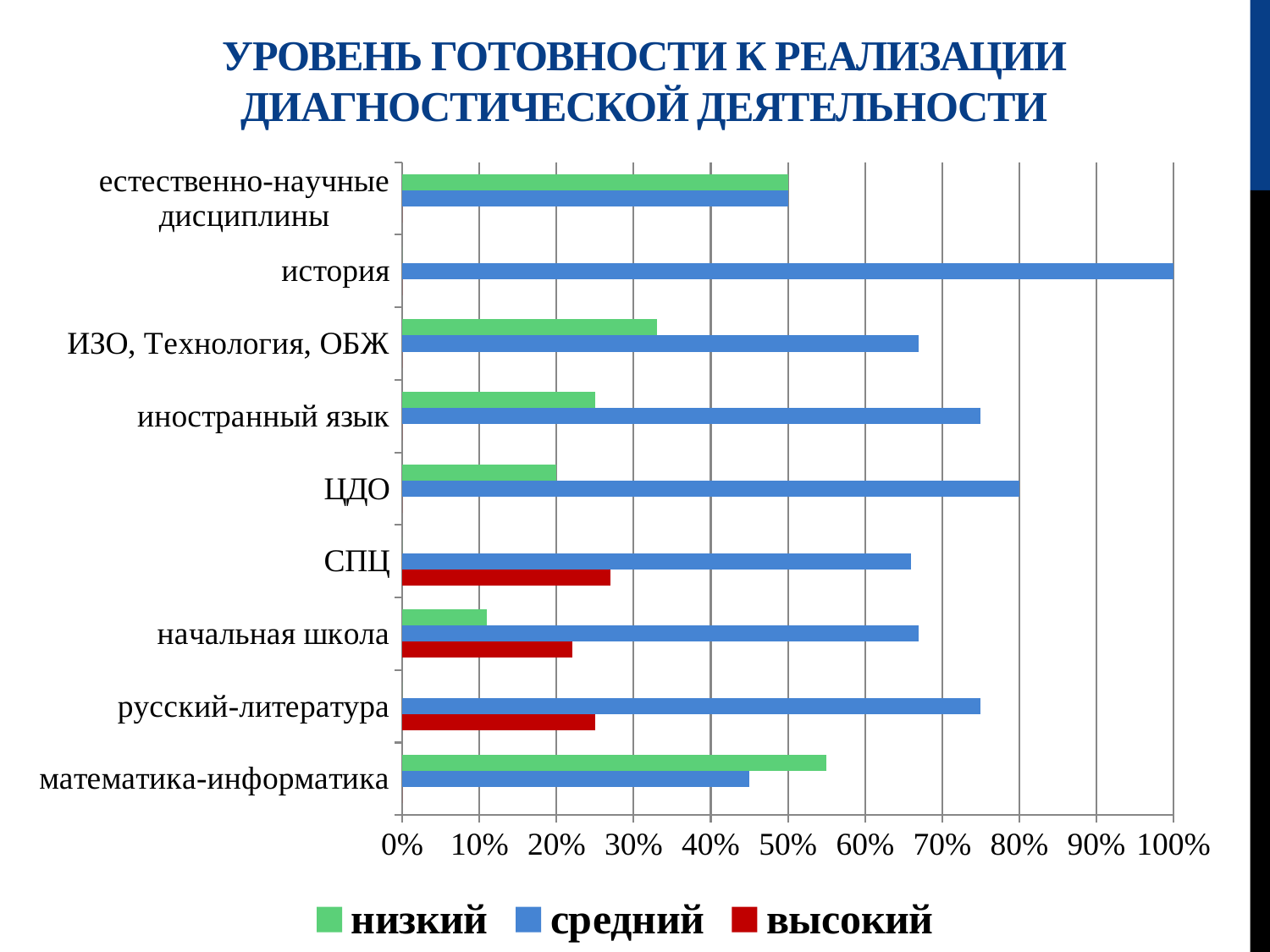
What is the value of the средний series for история? 100% Which series is shown in red in the legend? высокий Is the value of the высокий series for СПЦ greater or less than 30%? less For математика-информатика, which is larger: the низкий value or the средний value? низкий How many categories are shown on the vertical axis of the chart? 9 Which category has the highest value for the средний series? история How many series does the legend list? 3 What kind of chart is shown on the slide? bar chart Is the value of the низкий series for ИЗО, Технология, ОБЖ greater or less than 40%? less Is the value of the средний series for иностранный язык greater or less than 70%? greater What is the value of the средний series for ЦДО? 80%